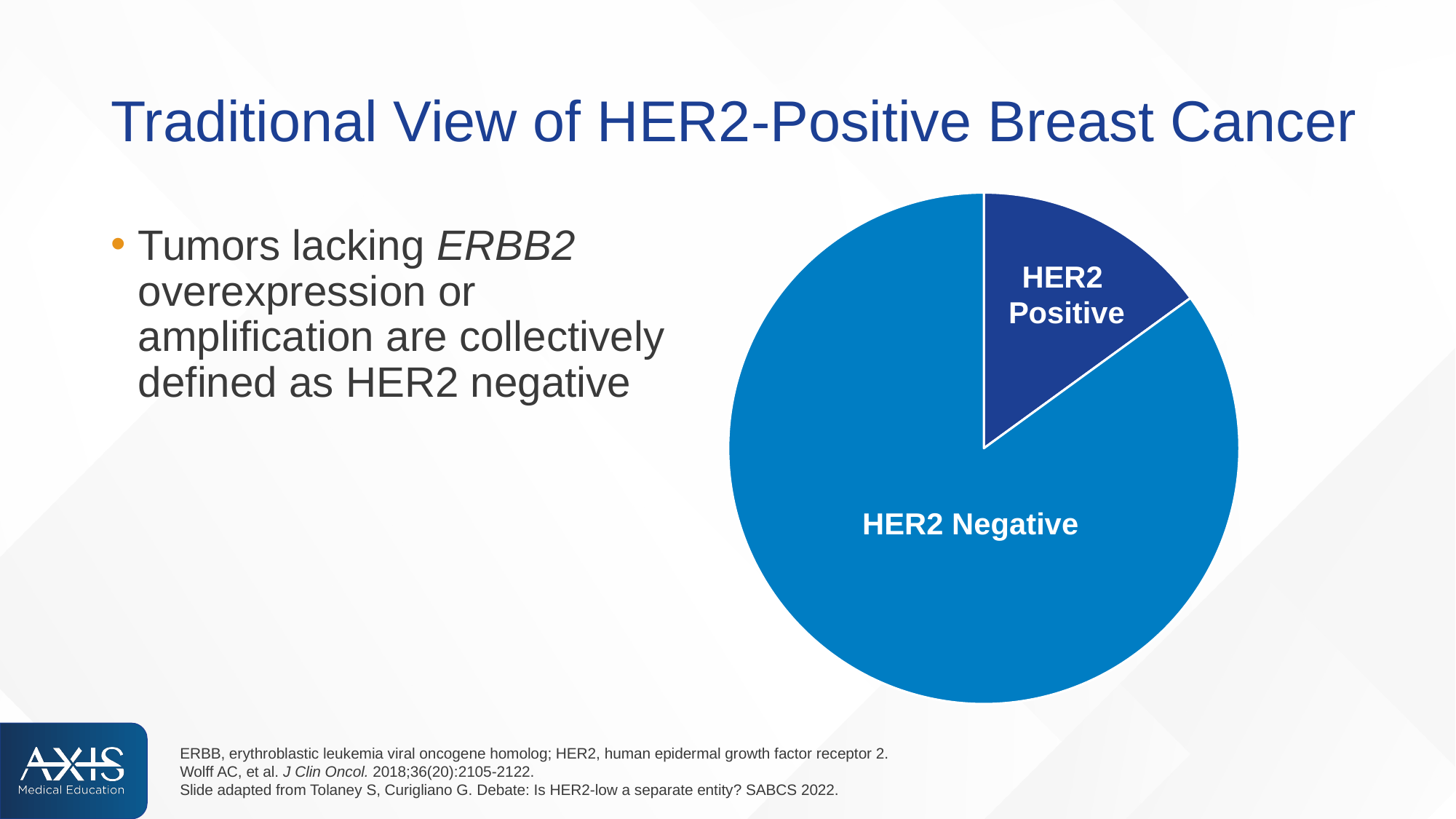
Which slice of the pie chart is shown in the darker blue colour? HER2 Positive Which slice is larger in the pie chart, HER2 Positive or HER2 Negative? HER2 Negative Which slice of the pie chart is the largest? HER2 Negative Which slice of the pie chart is the smallest? HER2 Positive How many slices does the pie chart have? 2 What kind of chart is shown on the slide? pie chart What are the labels of the two slices in the pie chart? HER2 Positive and HER2 Negative Does the HER2 Positive slice take up more or less than half of the pie chart? less